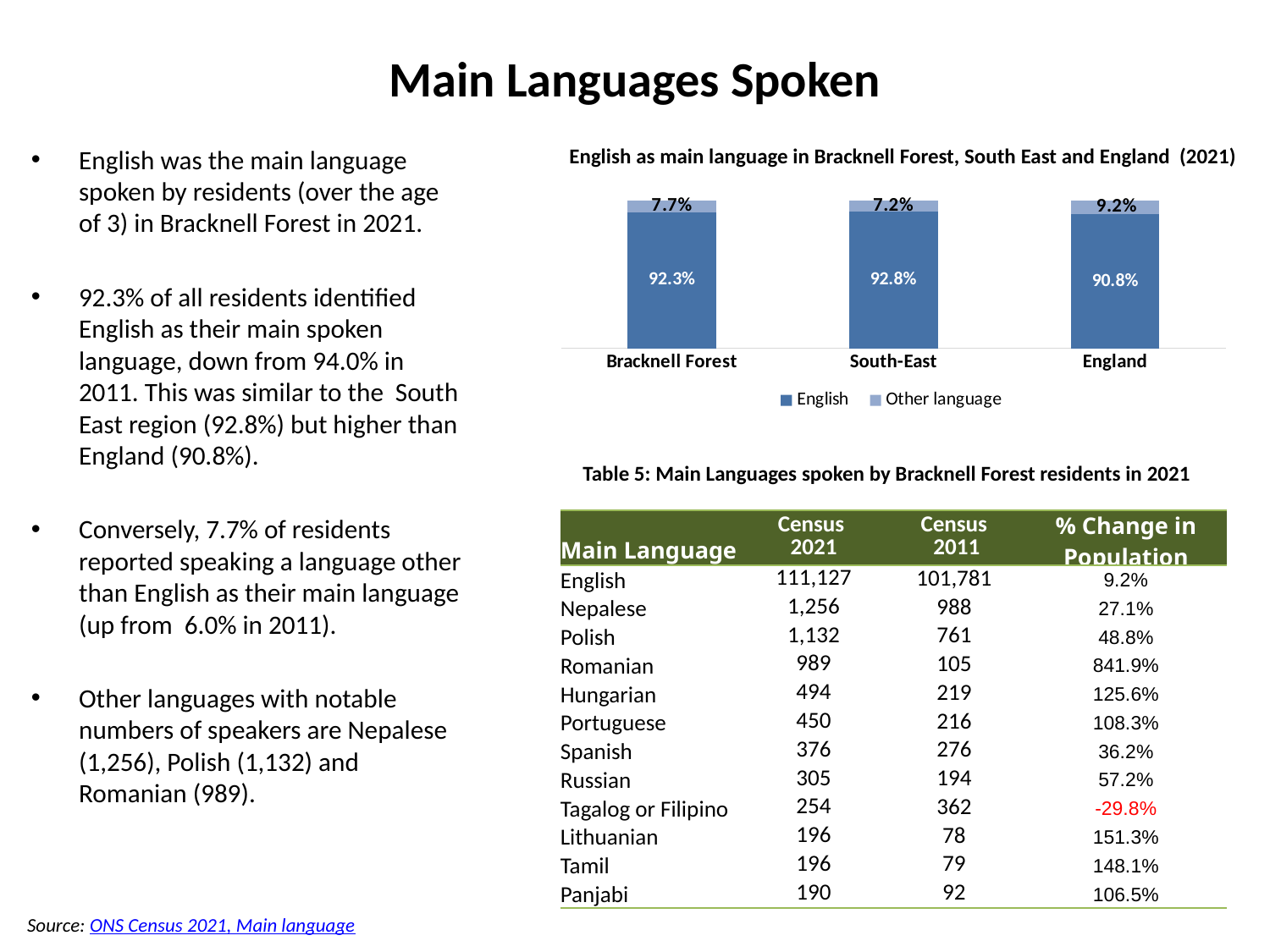
What is the total of the stacked bar for Bracknell Forest in the chart? 100% What is the English value for Bracknell Forest in the chart? 92.3% What is the difference between the English values for South-East and England in the chart? 2.0% What kind of chart is shown on the slide? Stacked bar chart What is the Other language value for England in the chart? 9.2% Which area has the highest English value in the chart? South-East How many areas are shown on the x axis of the chart? 3 What is the title of the chart? English as main language in Bracknell Forest, South East and England (2021) Which area has the lowest English value in the chart? England Which is larger in the chart: the Other language value for Bracknell Forest or for South-East? Bracknell Forest What is the Other language value for South-East in the chart? 7.2% How many series does the chart legend list? 2